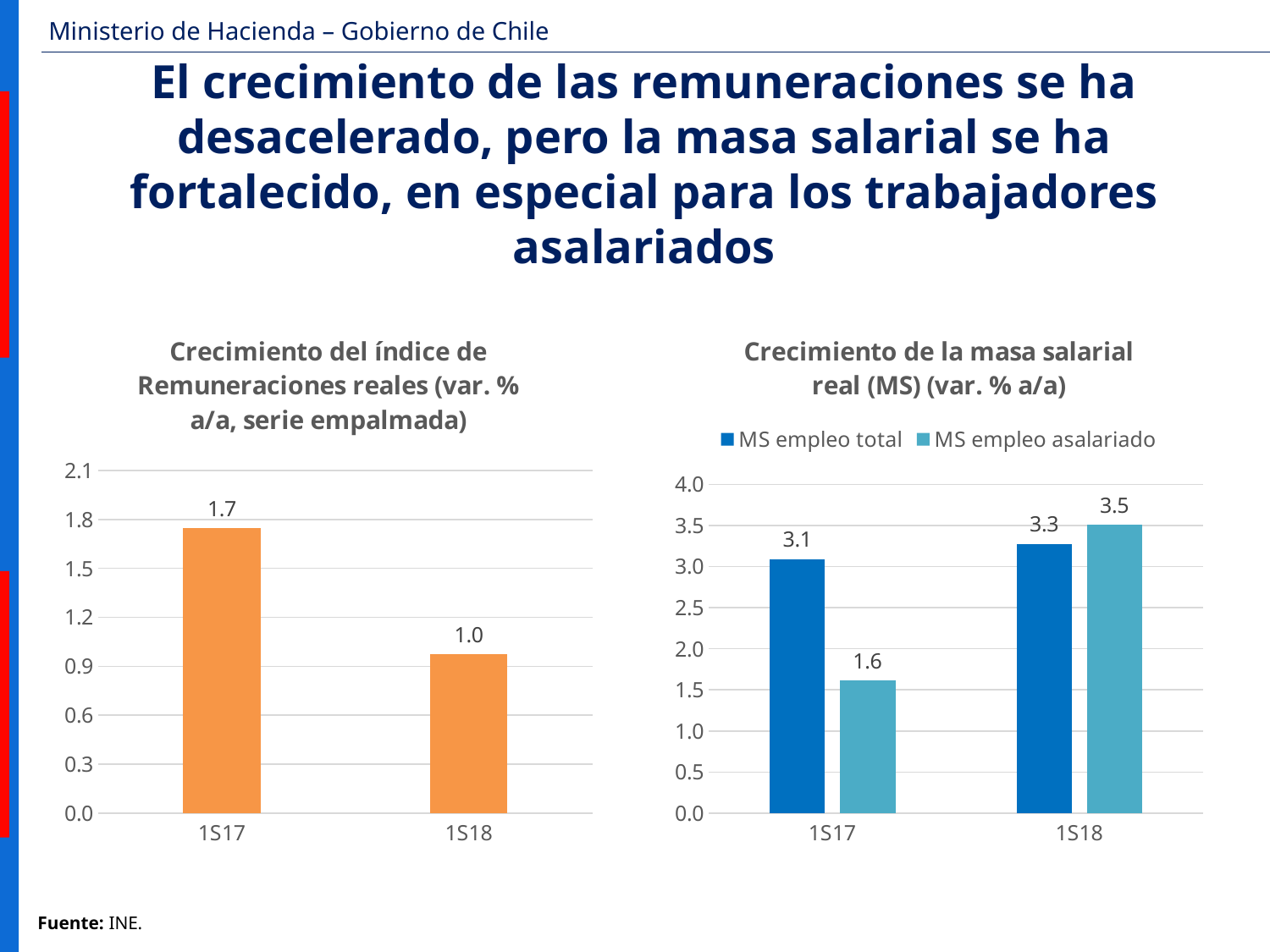
In the left chart (Crecimiento del índice de Remuneraciones reales), what is the difference between the 1S17 and 1S18 values? 0.7 In the left chart (Crecimiento del índice de Remuneraciones reales), what is the value for 1S17? 1.7 In the right chart (Crecimiento de la masa salarial real), which bar has the lowest value? MS empleo asalariado in 1S17 In the right chart (Crecimiento de la masa salarial real), what is the difference between MS empleo asalariado in 1S18 and 1S17? 1.9 In the right chart (Crecimiento de la masa salarial real), what is the value of MS empleo total for 1S18? 3.3 In the left chart (Crecimiento del índice de Remuneraciones reales), what is the value for 1S18? 1.0 In the right chart (Crecimiento de la masa salarial real), what is the value of MS empleo asalariado for 1S17? 1.6 In the left chart (Crecimiento del índice de Remuneraciones reales), how many categories are shown on the x axis? 2 What kind of chart is the right chart (Crecimiento de la masa salarial real)? bar chart In the right chart (Crecimiento de la masa salarial real), which series has the higher value in 1S17? MS empleo total In the right chart (Crecimiento de la masa salarial real), how many series does the legend list? 2 In the left chart (Crecimiento del índice de Remuneraciones reales), do the values rise or fall from 1S17 to 1S18? fall